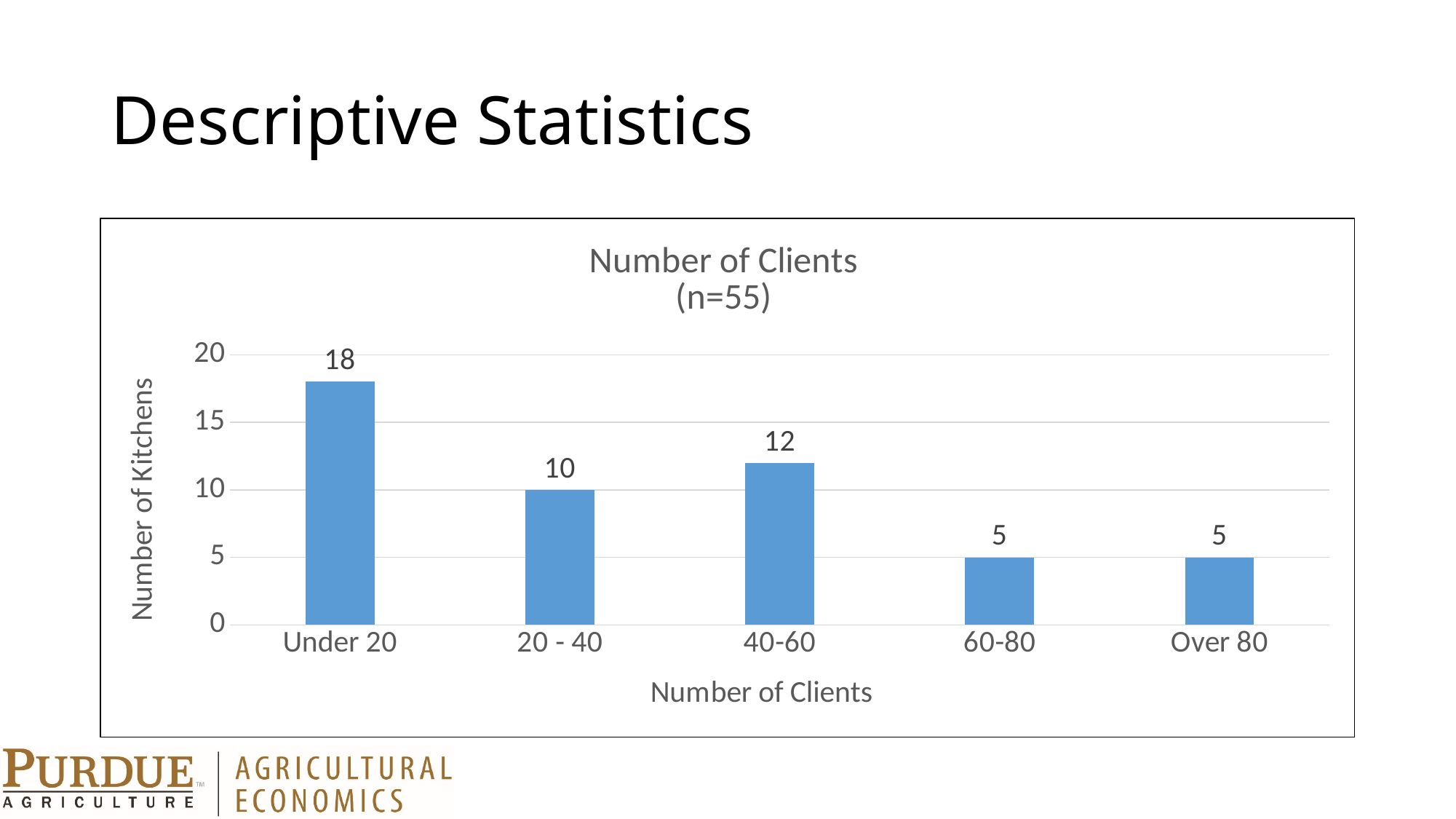
What is the label of the y axis? Number of Kitchens What is the difference in number of kitchens between the Under 20 and 40-60 categories? 6 Is the value for the Under 20 category greater or less than 15? greater How many kitchens have under 20 clients? 18 What kind of chart is shown on the slide? Bar chart What is the value for the 20 - 40 category? 10 What is the title of the chart? Number of Clients (n=55) Which has more kitchens, the 20 - 40 category or the 40-60 category? 40-60 What is the number of kitchens in the 40-60 clients category? 12 Which client category has the highest number of kitchens? Under 20 How many client categories are shown on the x axis? 5 What is the total number of kitchens across the 60-80 and Over 80 categories? 10